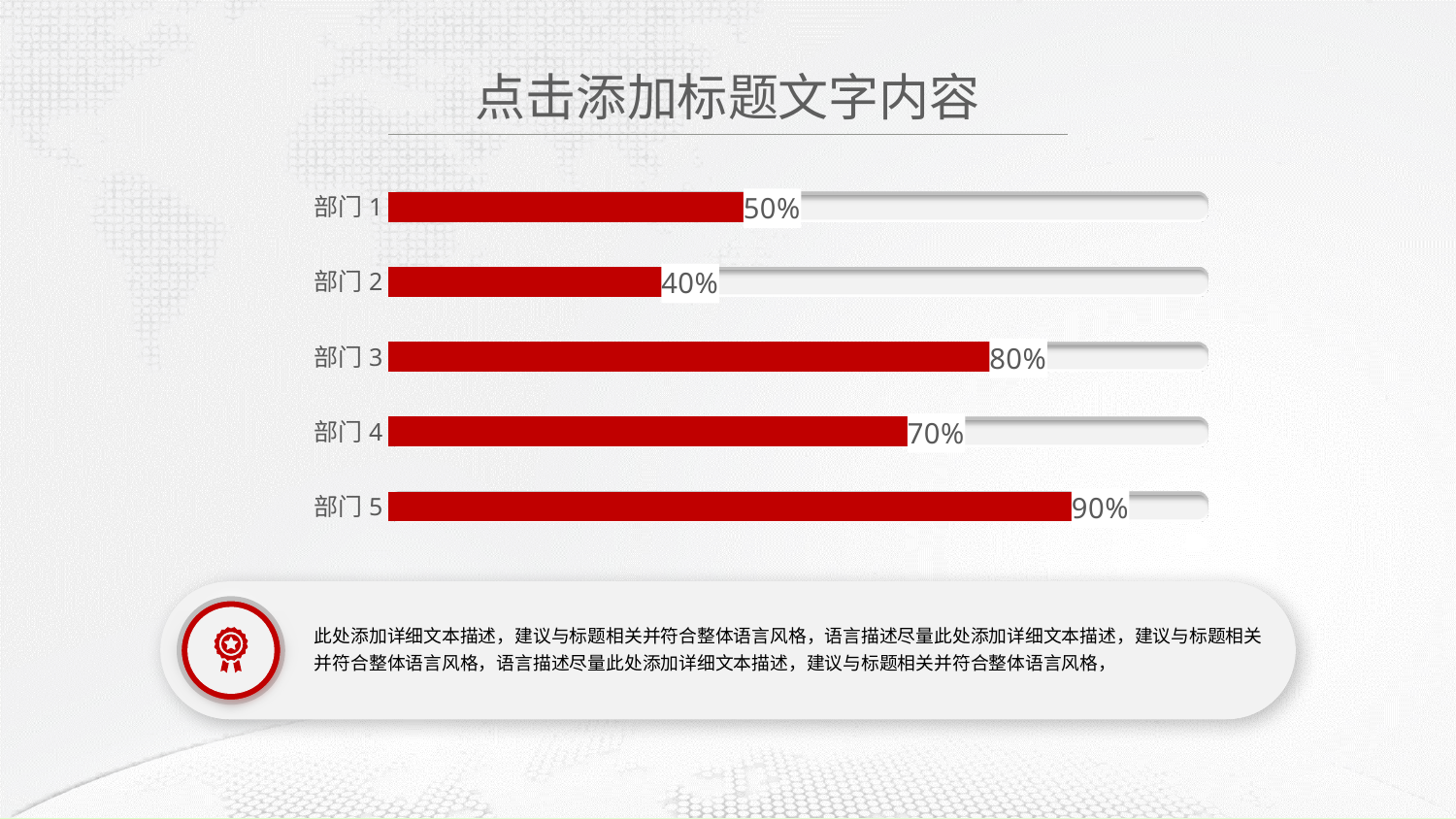
How many categories are shown in the chart? 5 What is the value for 部门 3? 80% What is the difference between the values for 部门 5 and 部门 2? 50% What is the difference between the values for 部门 3 and 部门 4? 10% What colour are the bars in the chart? Red What is the value for 部门 1? 50% Which category has the highest value? 部门 5 Which is larger, the value for 部门 1 or the value for 部门 4? 部门 4 What is the value for 部门 4? 70% What kind of chart is shown on the slide? Bar chart Which category has the lowest value? 部门 2 What is the value for 部门 5? 90%